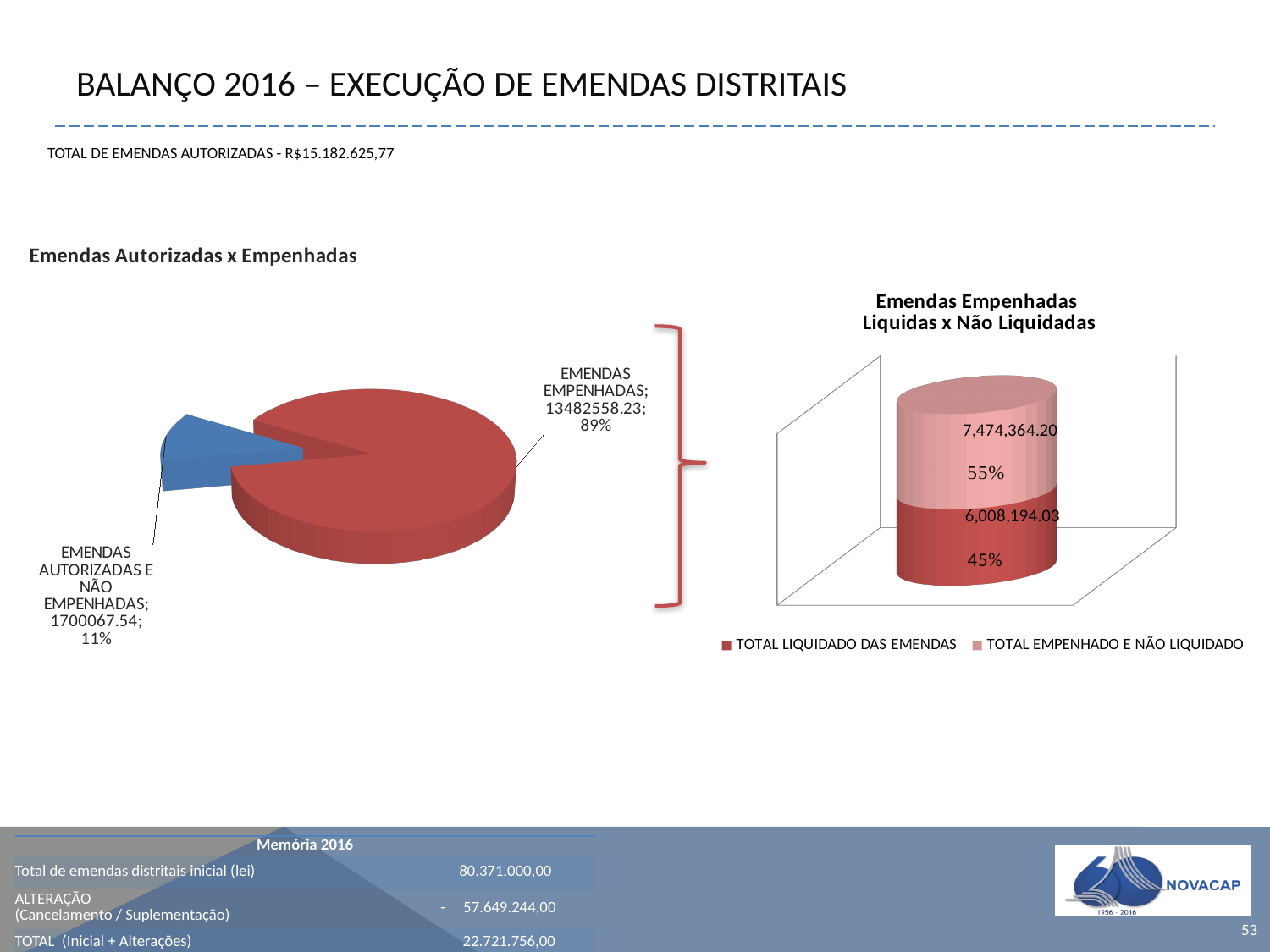
In the 'Emendas Empenhadas Liquidas x Não Liquidadas' chart, which is larger: TOTAL LIQUIDADO DAS EMENDAS or TOTAL EMPENHADO E NÃO LIQUIDADO? TOTAL EMPENHADO E NÃO LIQUIDADO In the 'Emendas Autorizadas x Empenhadas' chart, how many slices does the pie have? 2 In the 'Emendas Empenhadas Liquidas x Não Liquidadas' chart, what percentage is shown for TOTAL LIQUIDADO DAS EMENDAS? 45% In the 'Emendas Autorizadas x Empenhadas' chart, which slice is the largest? EMENDAS EMPENHADAS In the 'Emendas Empenhadas Liquidas x Não Liquidadas' chart, how many series does the legend list? 2 In the 'Emendas Autorizadas x Empenhadas' chart, what share of the pie is EMENDAS AUTORIZADAS E NÃO EMPENHADAS? 11% In the 'Emendas Autorizadas x Empenhadas' chart, what kind of chart is shown? Pie chart In the 'Emendas Autorizadas x Empenhadas' chart, what share of the pie is EMENDAS EMPENHADAS? 89% In the 'Emendas Empenhadas Liquidas x Não Liquidadas' chart, what value is shown for TOTAL LIQUIDADO DAS EMENDAS? 6,008,194.03 In the 'Emendas Autorizadas x Empenhadas' chart, what value is shown for EMENDAS EMPENHADAS? 13482558.23 In the 'Emendas Empenhadas Liquidas x Não Liquidadas' chart, what value is shown for TOTAL EMPENHADO E NÃO LIQUIDADO? 7,474,364.20 In the 'Emendas Autorizadas x Empenhadas' chart, what value is shown for EMENDAS AUTORIZADAS E NÃO EMPENHADAS? 1700067.54